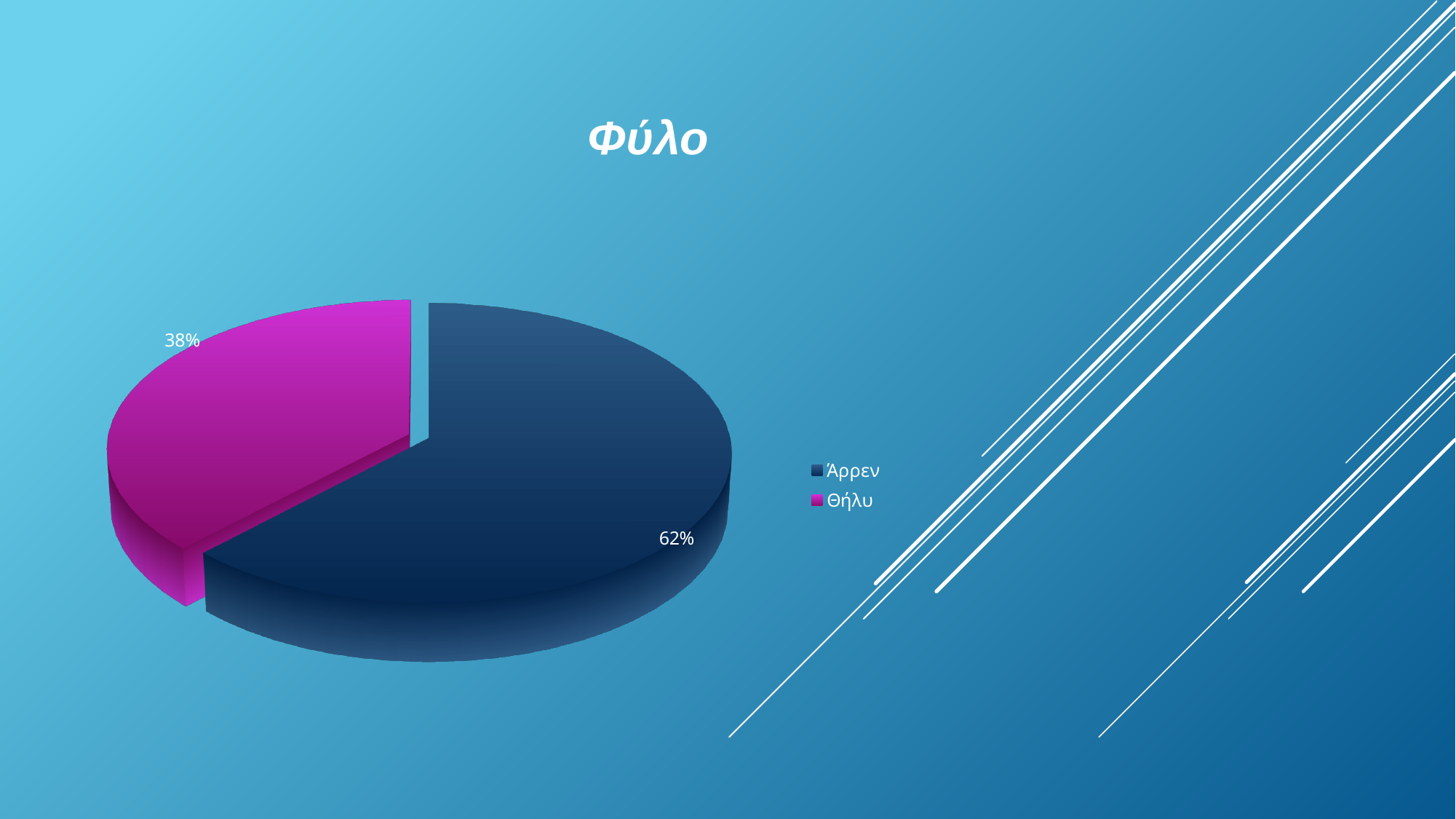
Which is larger, the share for Άρρεν or the share for Θήλυ? Άρρεν Which category has the largest share of the pie? Άρρεν How many slices does the pie chart have? 2 What type of chart is shown on the slide? Pie chart What is the total of the two slice percentages? 100% What percentage of the pie is Θήλυ? 38% What percentage of the pie is Άρρεν? 62% What colour is the Θήλυ slice? Magenta How many entries does the legend list? 2 What is the title of the chart? Φύλο Which category has the smallest share of the pie? Θήλυ What is the difference in percentage points between Άρρεν and Θήλυ? 24